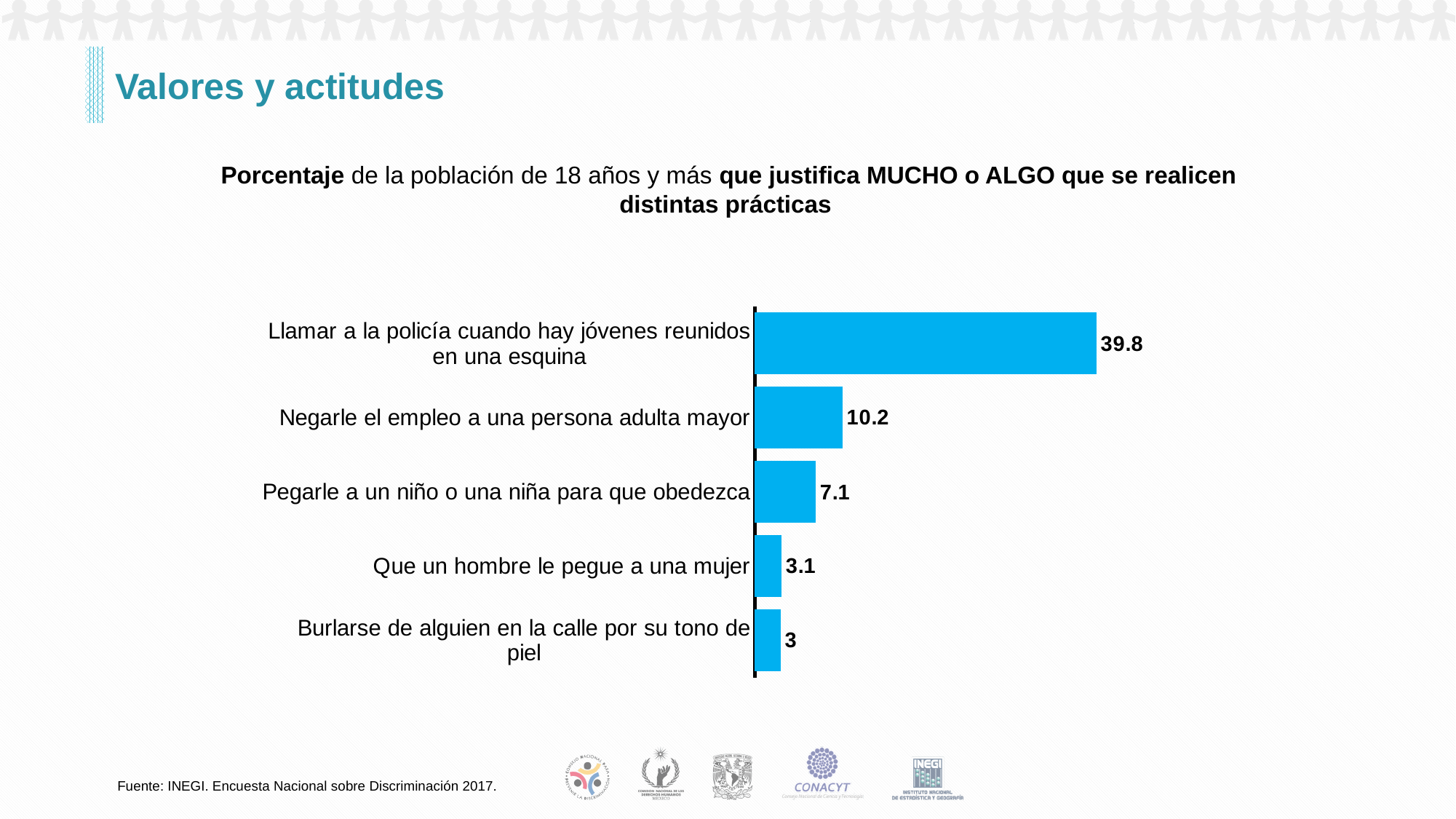
What is the value for 'Burlarse de alguien en la calle por su tono de piel'? 3 What is the difference between the values for 'Llamar a la policía cuando hay jóvenes reunidos en una esquina' and 'Negarle el empleo a una persona adulta mayor'? 29.6 What kind of chart is shown on the slide? Bar chart What is the value for 'Que un hombre le pegue a una mujer'? 3.1 What is the source cited for the chart data? INEGI. Encuesta Nacional sobre Discriminación 2017. What is the value for 'Negarle el empleo a una persona adulta mayor'? 10.2 Which practice has the highest percentage? Llamar a la policía cuando hay jóvenes reunidos en una esquina Which is larger: the value for 'Pegarle a un niño o una niña para que obedezca' or for 'Que un hombre le pegue a una mujer'? Pegarle a un niño o una niña para que obedezca How many practices (categories) are shown in the chart? 5 Which practice has the lowest percentage? Burlarse de alguien en la calle por su tono de piel What is the value for 'Llamar a la policía cuando hay jóvenes reunidos en una esquina'? 39.8 What is the value for 'Pegarle a un niño o una niña para que obedezca'? 7.1